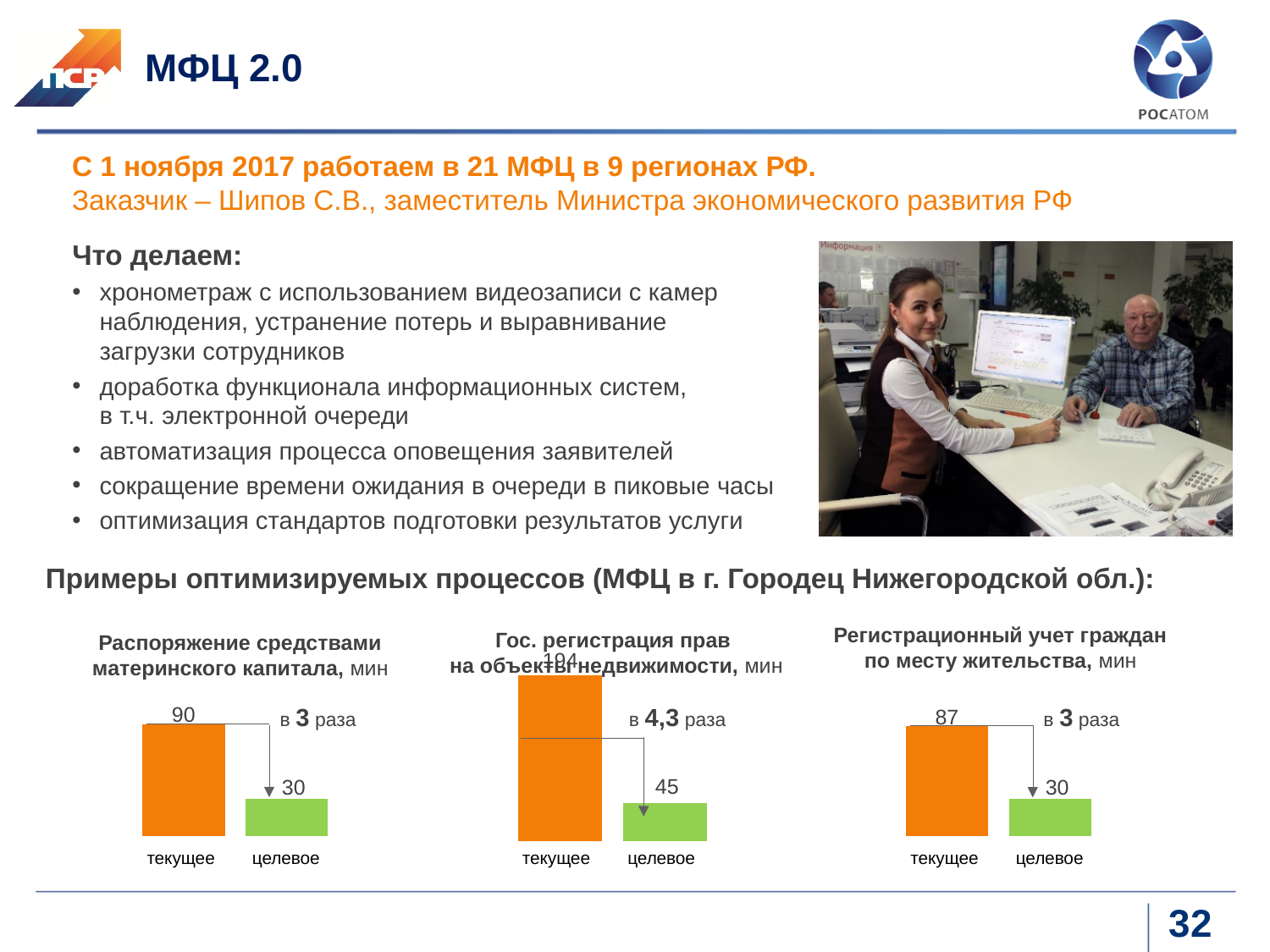
How many bars does the chart 'Распоряжение средствами материнского капитала' have? 2 What type of chart is used for 'Регистрационный учет граждан по месту жительства'? bar chart In the chart 'Распоряжение средствами материнского капитала', what is the value for 'целевое'? 30 In the chart 'Регистрационный учет граждан по месту жительства', what is the value for 'текущее'? 87 In the chart 'Распоряжение средствами материнского капитала', what is the difference between the 'текущее' and 'целевое' values? 60 In the chart 'Гос. регистрация прав на объекты недвижимости', by what factor does the annotation say the value is reduced? в 4,3 раза In the chart 'Гос. регистрация прав на объекты недвижимости', which bar is higher, 'текущее' or 'целевое'? текущее In the chart 'Гос. регистрация прав на объекты недвижимости', what is the value for 'целевое'? 45 In the chart 'Распоряжение средствами материнского капитала', what is the value for 'текущее'? 90 In the chart 'Регистрационный учет граждан по месту жительства', what is the difference between the 'текущее' and 'целевое' values? 57 In the chart 'Регистрационный учет граждан по месту жительства', what is the value for 'целевое'? 30 In the chart 'Гос. регистрация прав на объекты недвижимости', what is the value for 'текущее'? 194